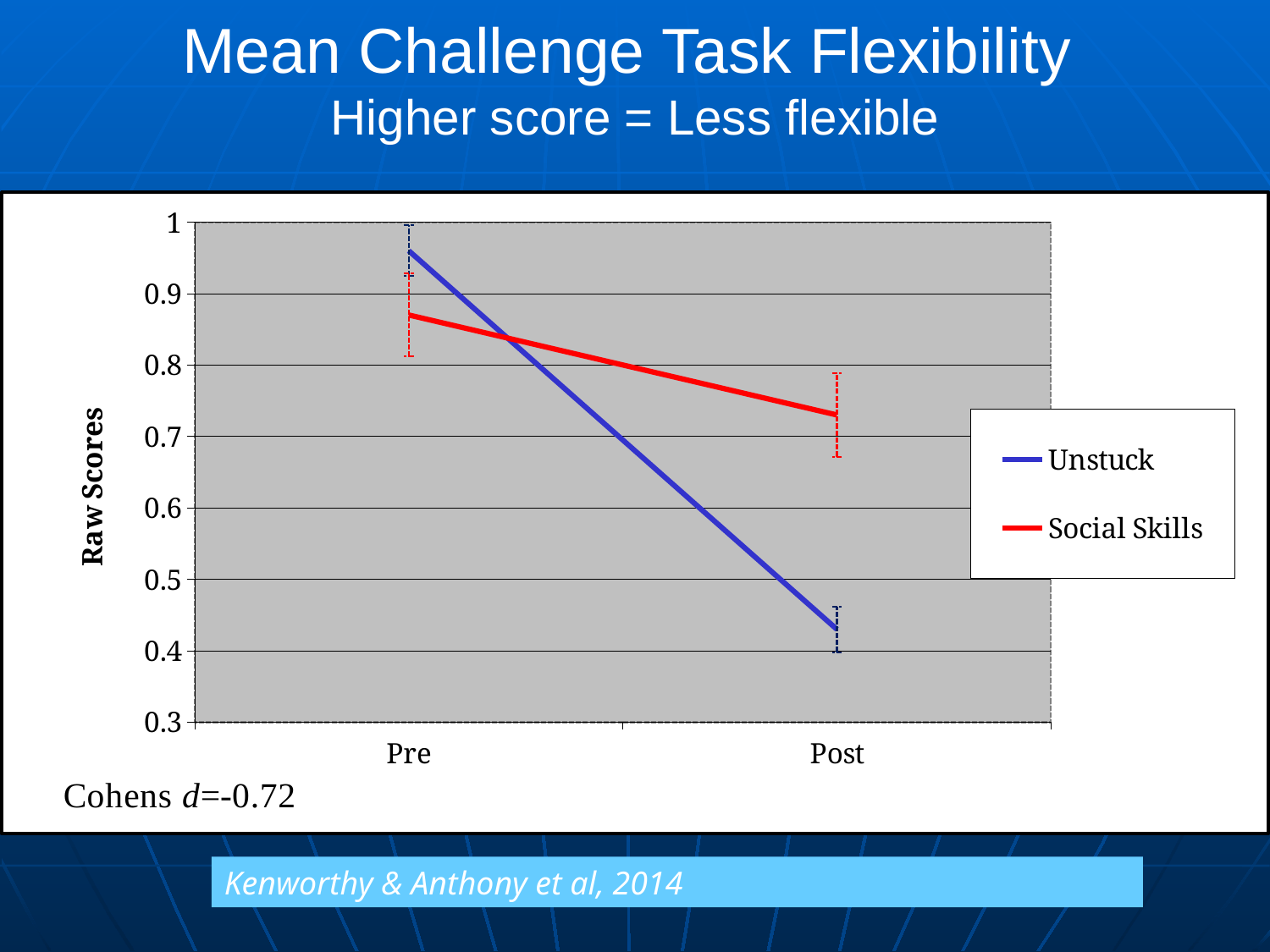
How many series does the legend list? 2 Is the value for Unstuck at Pre greater or less than 0.9? greater How many categories are shown on the x axis? 2 Is the value for Social Skills at Post greater or less than 0.7? greater Does the Unstuck series rise or fall from Pre to Post? fall Which colour is used for the Social Skills series? red What kind of chart is shown on the slide? line chart At Pre, which series has the higher value, Unstuck or Social Skills? Unstuck Is the value for Unstuck at Post greater or less than 0.5? less At Post, which series has the higher value, Unstuck or Social Skills? Social Skills What is the label of the y axis? Raw Scores Does the Social Skills series rise or fall from Pre to Post? fall